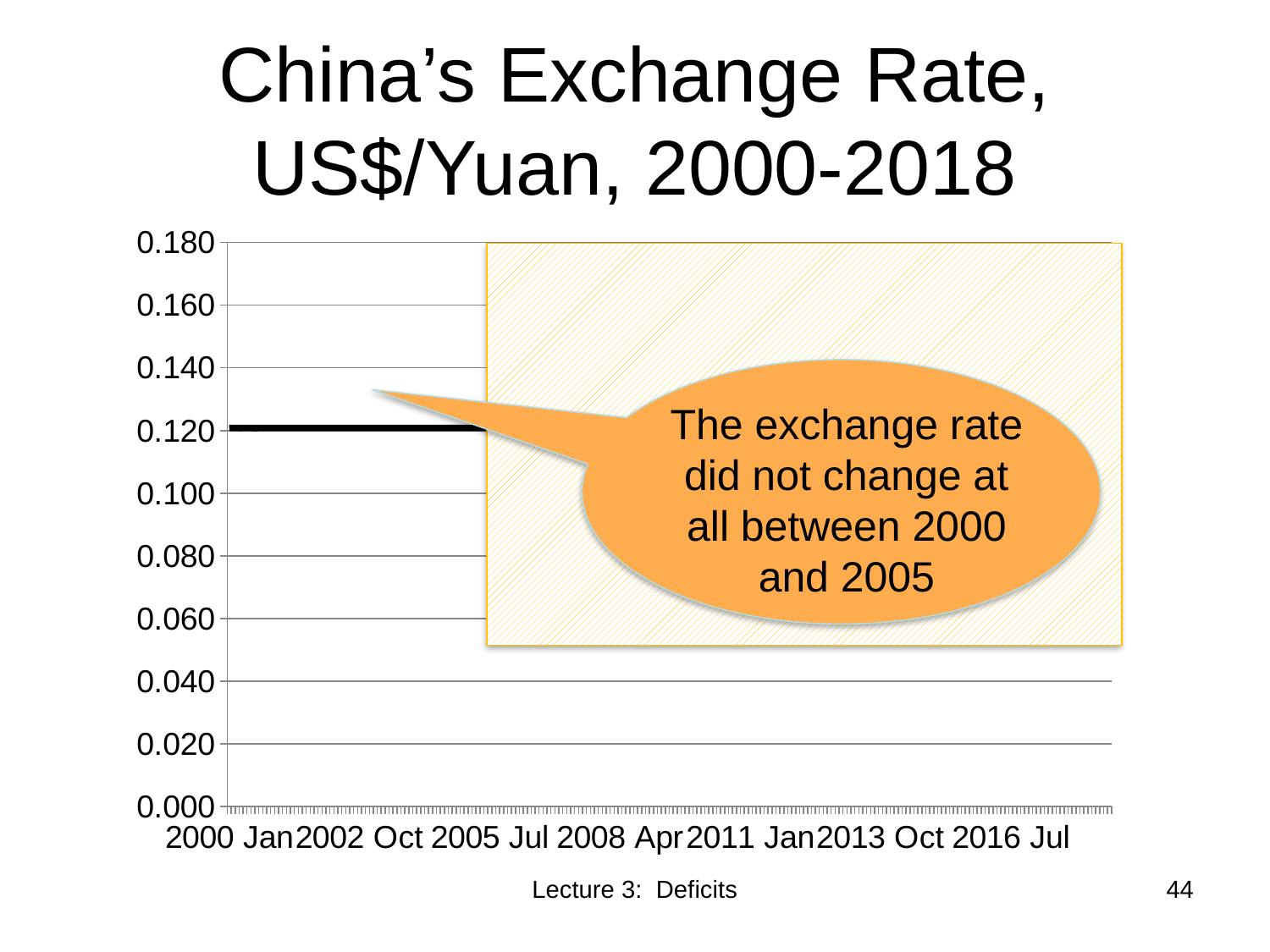
Between 2000 Jan and 2005, does the plotted exchange rate line rise, fall, or stay flat? stay flat What is the title of the chart? China's Exchange Rate, US$/Yuan, 2000-2018 Is the exchange rate value at 2002 Oct greater or less than 0.080? greater Is the exchange rate value at 2000 Jan greater or less than 0.140? less Is the exchange rate value at 2002 Oct greater or less than 0.160? less What kind of chart is shown on the slide? line chart According to the callout on the chart, between which years did the exchange rate not change at all? 2000 and 2005